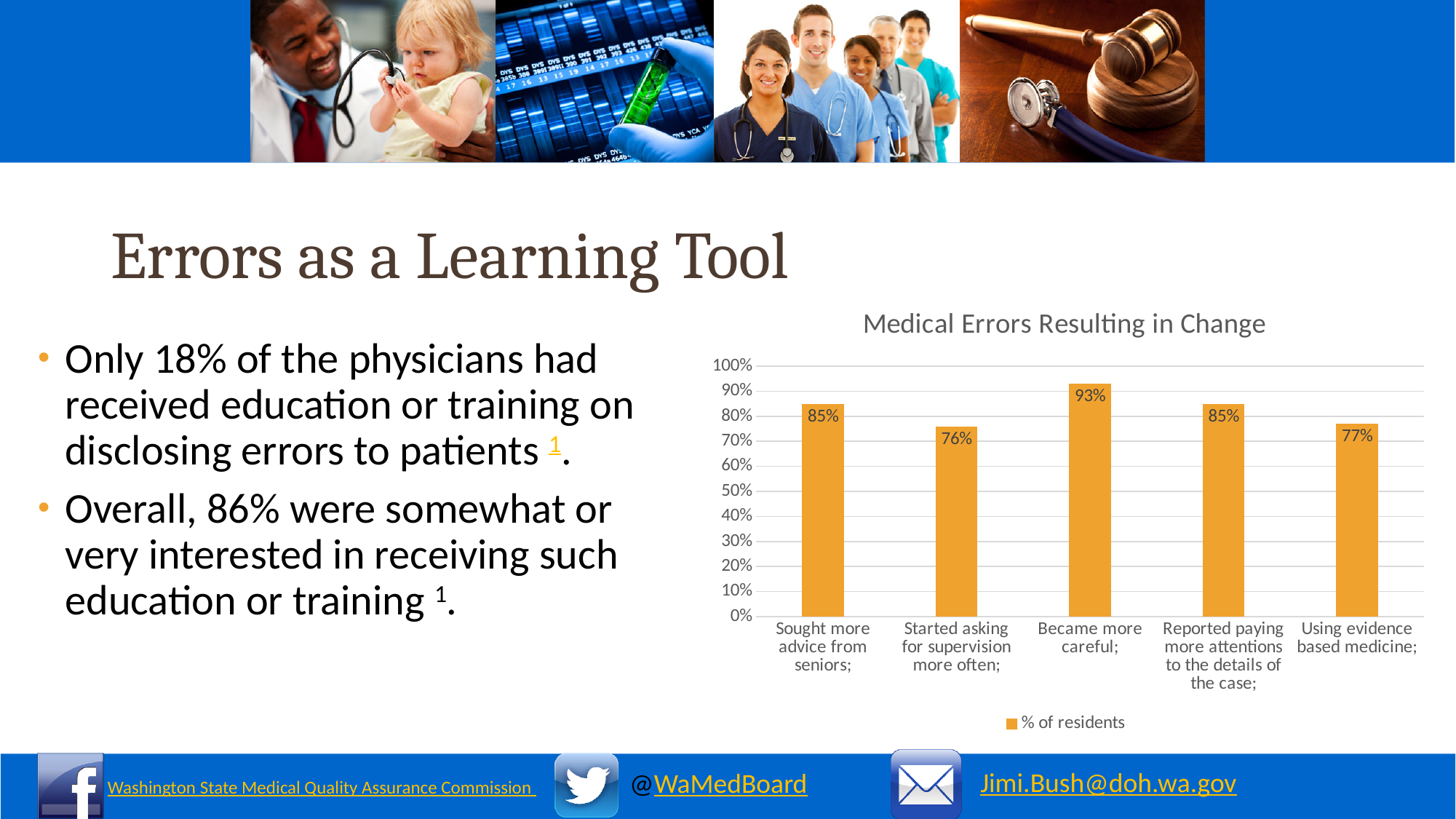
Which is larger, the value for 'Sought more advice from seniors;' or the value for 'Using evidence based medicine;'? Sought more advice from seniors; What is the value for 'Started asking for supervision more often;'? 76% What is the title of the chart? Medical Errors Resulting in Change Which category has the lowest value? Started asking for supervision more often; Which category has the highest value? Became more careful; What is the value for 'Sought more advice from seniors;'? 85% What is the value for 'Using evidence based medicine;'? 77% How many series does the legend list? 1 What is the value for 'Became more careful;'? 93% What kind of chart is shown? Bar chart How many categories are shown on the x axis? 5 What is the difference between the values for 'Became more careful;' and 'Started asking for supervision more often;'? 17%